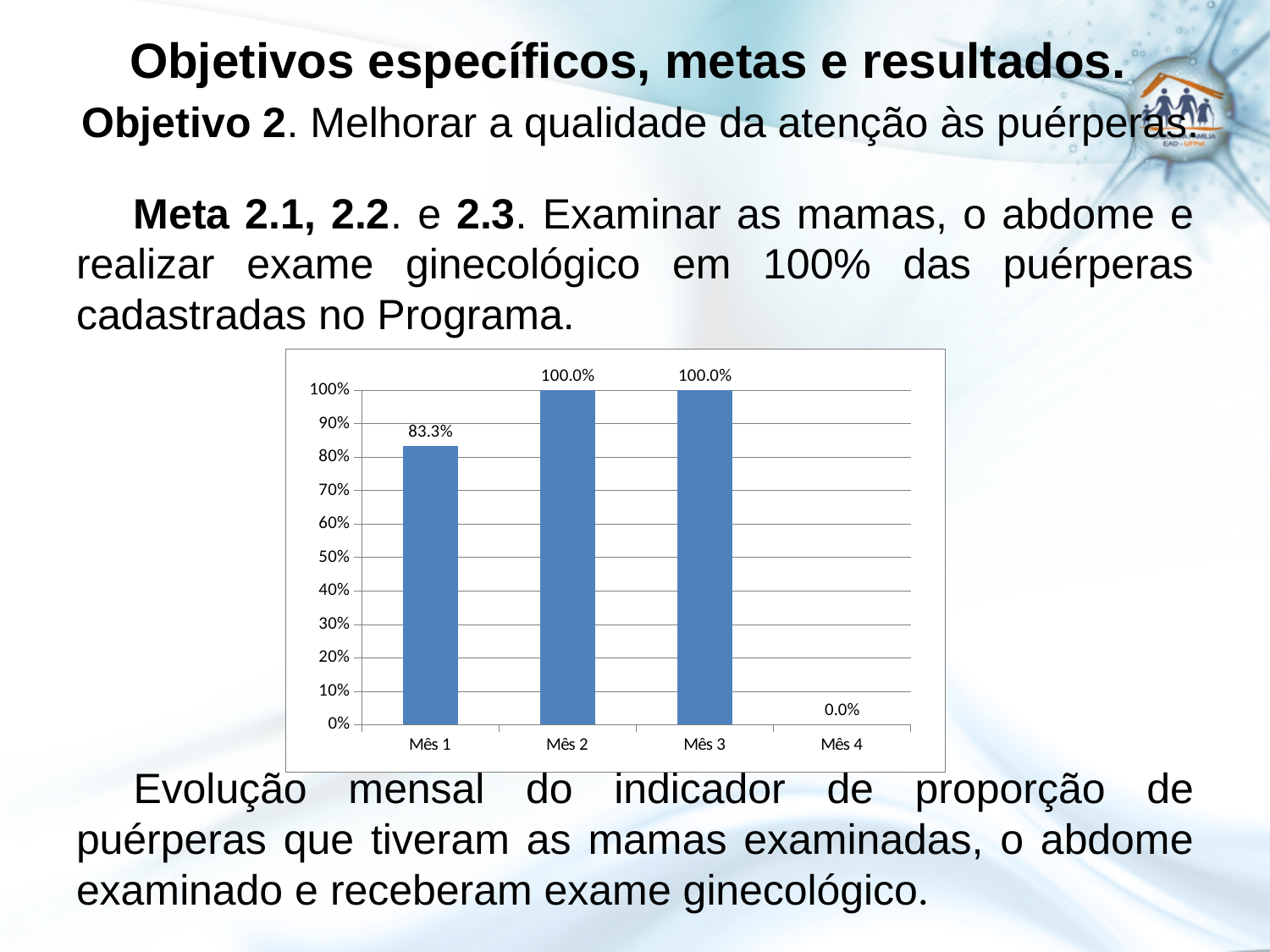
What is the highest value shown on the y axis? 100% What colour are the bars in the chart? blue Which month has the lowest value? Mês 4 What is the value for Mês 1? 83.3% How many months are shown on the x axis? 4 What kind of chart is shown on the slide? bar chart What is the value for Mês 4? 0.0% Which is larger, the value for Mês 1 or the value for Mês 3? Mês 3 What is the value for Mês 2? 100.0% Do the values rise or fall from Mês 3 to Mês 4? fall What is the difference between the values for Mês 2 and Mês 1? 16.7% Is the value for Mês 1 greater or less than 80%? greater